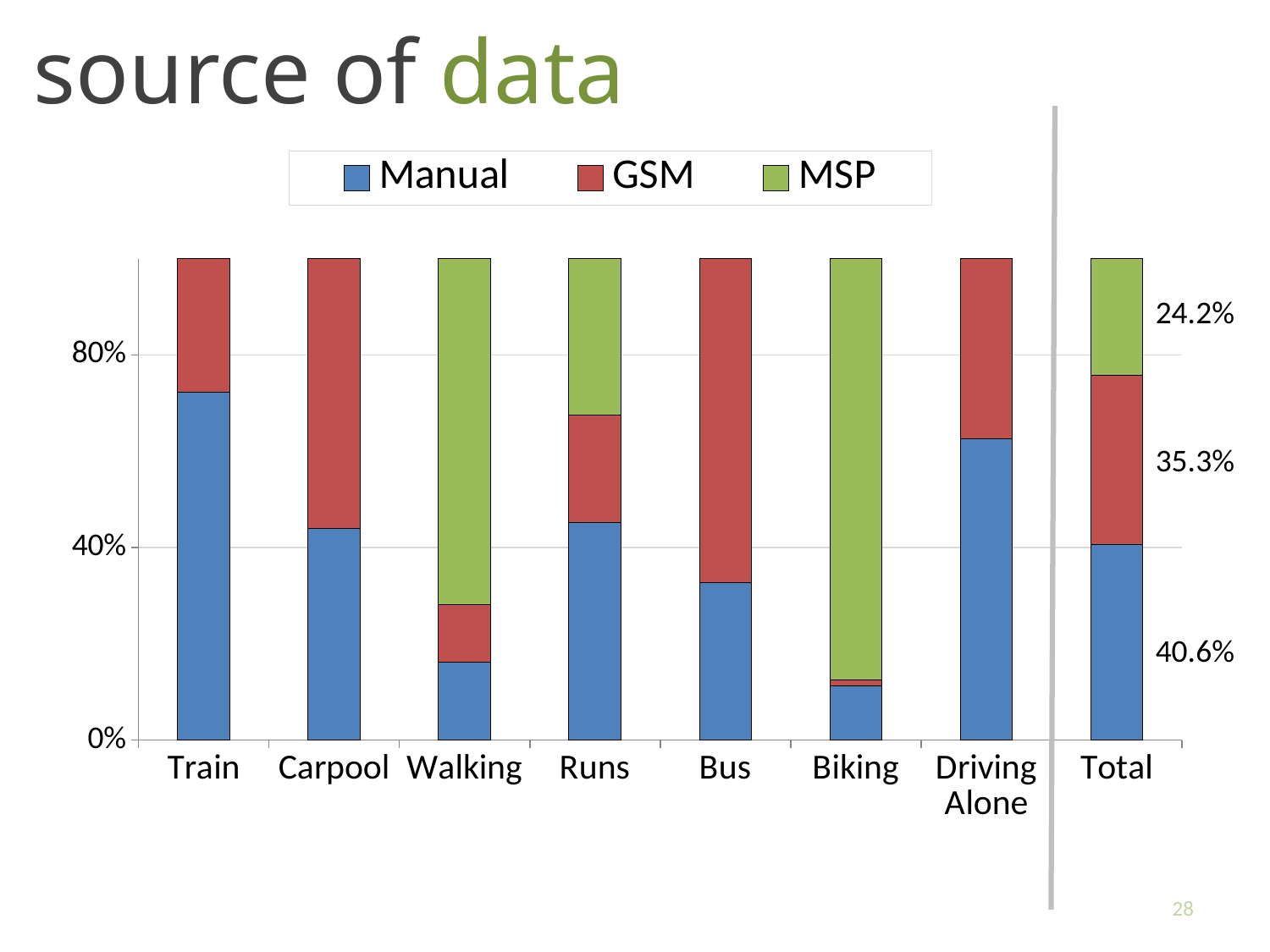
How many categories are shown on the x axis, including Total? 8 In the Total bar, which is larger, the Manual share or the GSM share? Manual How many series does the legend list? 3 Is the Manual share for Walking greater or less than 40%? less Which category has the largest Manual share? Train What kind of chart is shown on the slide? Stacked bar chart In the Total bar, how much larger is the Manual share than the MSP share? 16.4% Is the Manual share for Train greater or less than 40%? greater What is the MSP share shown for the Total bar? 24.2% Which category has the largest MSP share? Biking What is the GSM share shown for the Total bar? 35.3% What is the Manual share shown for the Total bar? 40.6%